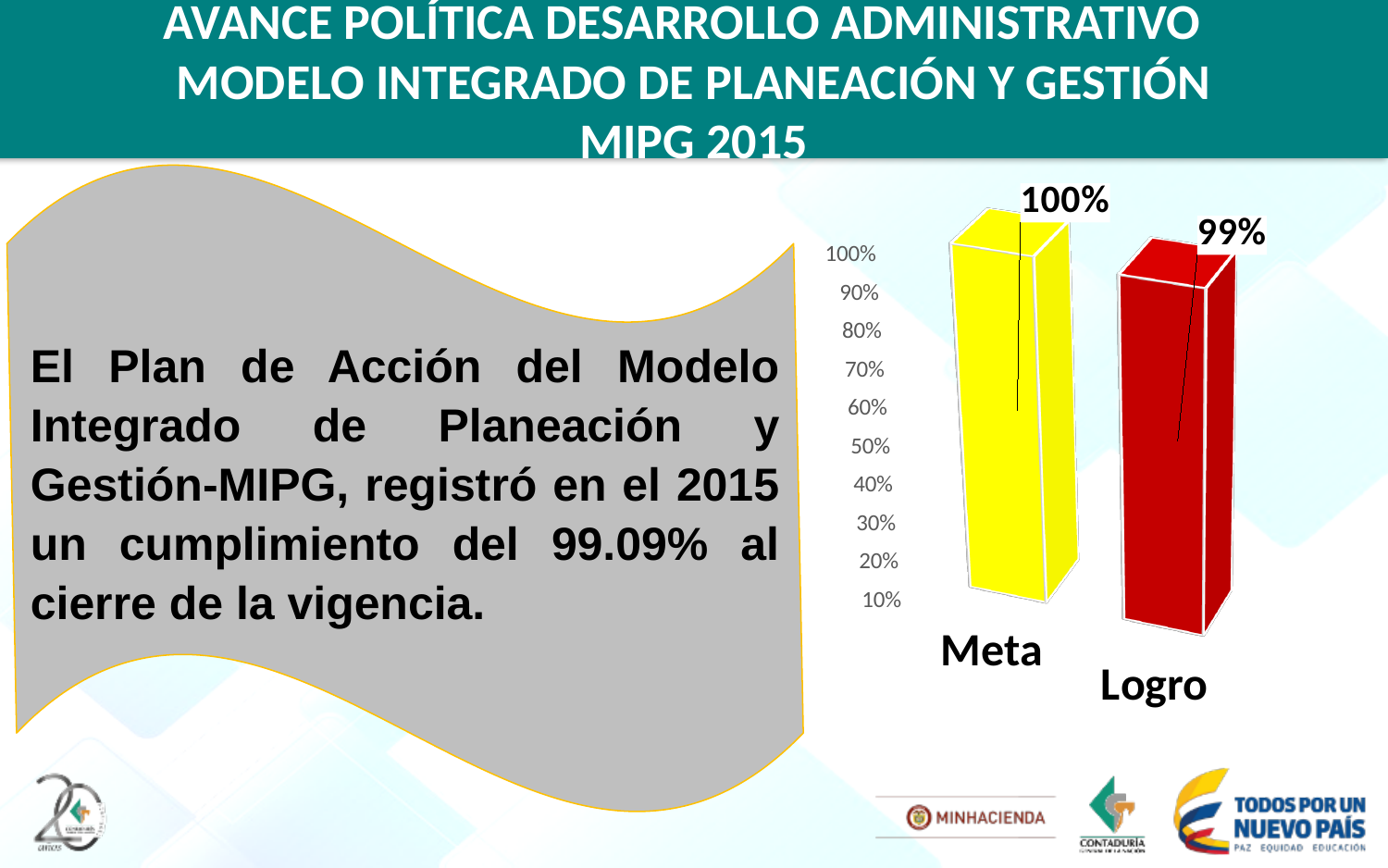
What colour is the bar for Meta? Yellow Which category has the highest value? Meta What value is shown for Meta? 100% Which is larger, the value for Meta or the value for Logro? Meta What is the difference between the values for Meta and Logro? 1% What kind of chart is shown on the slide? Bar chart What is the highest tick label on the vertical axis? 100% How many categories are plotted in the chart? 2 What value is shown for Logro? 99% What colour is the bar for Logro? Red Which category has the lowest value? Logro Is the value for Logro greater or less than 50%? greater